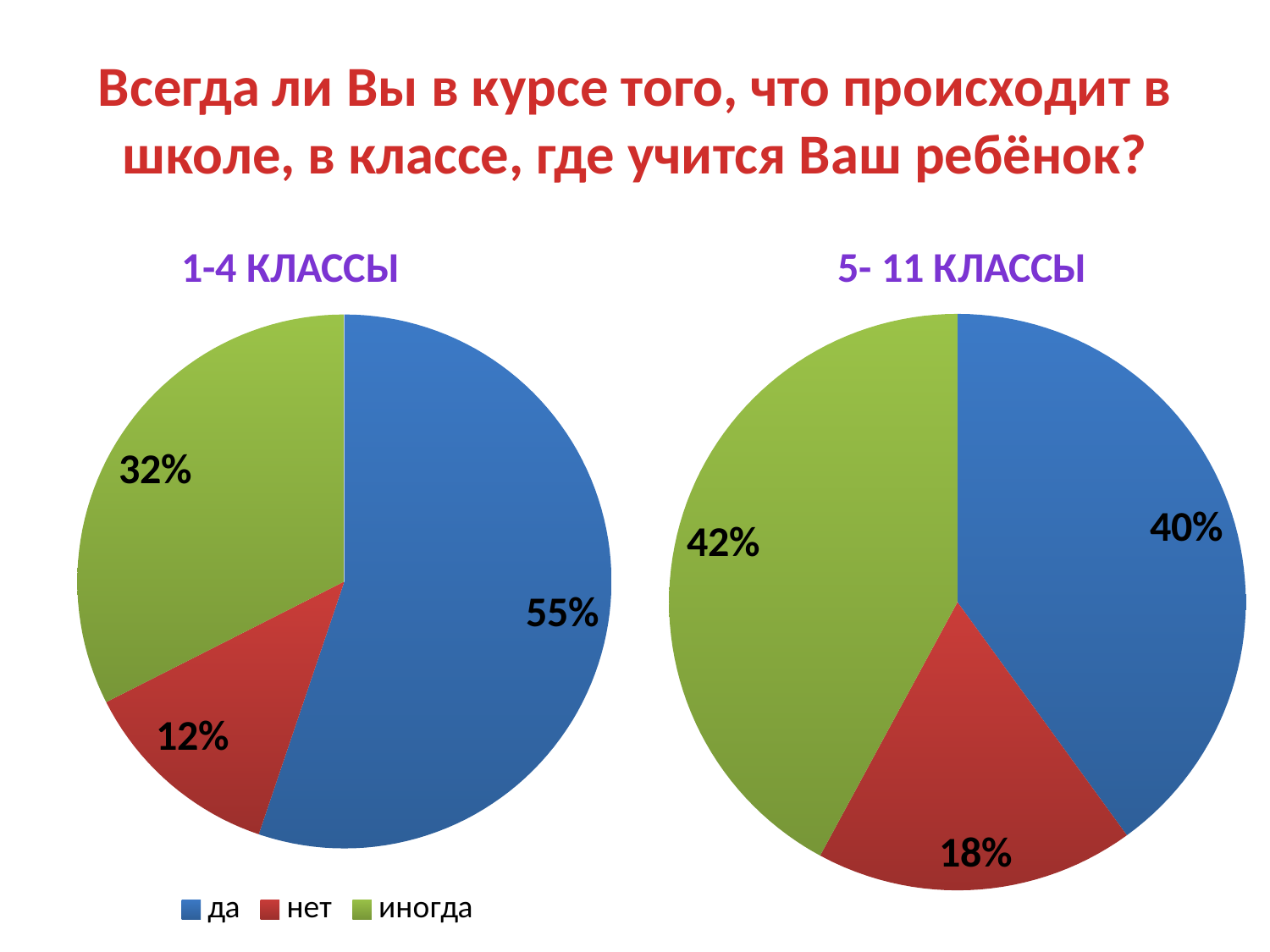
In the '1-4 КЛАССЫ' pie chart, which category has the smallest share? нет In the '1-4 КЛАССЫ' pie chart, what is the difference between the 'да' and 'иногда' percentages? 23% In the '5- 11 КЛАССЫ' pie chart, what percentage is shown on the red slice? 18% In the '1-4 КЛАССЫ' pie chart, what percentage is shown for 'иногда'? 32% How many entries does the legend list? 3 In the '1-4 КЛАССЫ' pie chart, which category has the largest share? да Which is larger: the 'нет' share in the '1-4 КЛАССЫ' chart or the red slice in the '5- 11 КЛАССЫ' chart? the red slice in the '5- 11 КЛАССЫ' chart In the '5- 11 КЛАССЫ' pie chart, what percentage is shown on the blue slice? 40% In the '1-4 КЛАССЫ' pie chart, what percentage is shown for 'да'? 55% In the '5- 11 КЛАССЫ' pie chart, what percentage is shown on the green slice? 42% In the '1-4 КЛАССЫ' pie chart, what percentage is shown for 'нет'? 12% What type of chart is used on this slide? pie chart